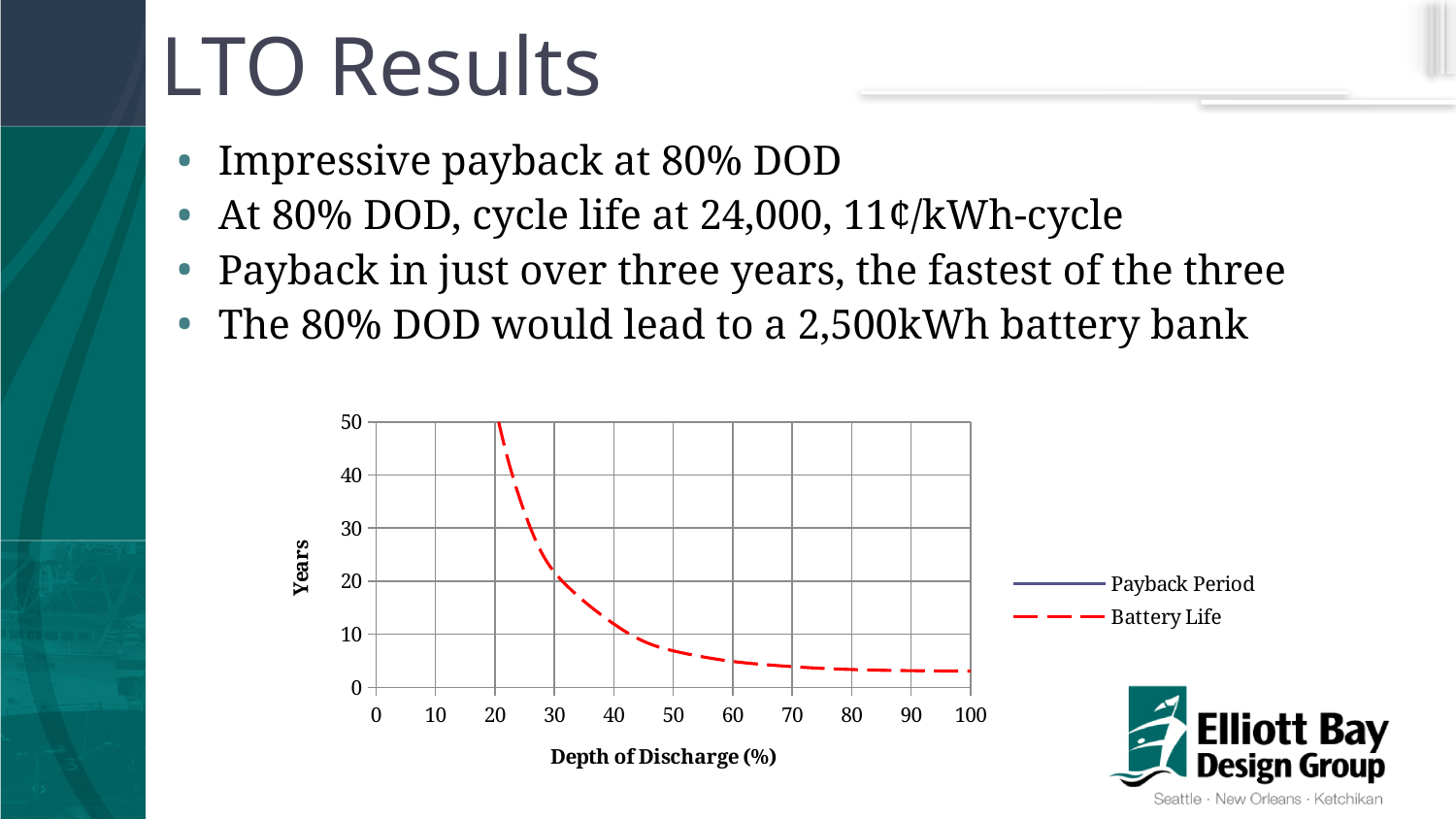
Is the Battery Life value at 80% Depth of Discharge greater or less than 10 years? less What kind of chart is shown on the slide? line chart What are the two series named in the chart legend? Payback Period and Battery Life Does the Battery Life curve rise or fall as Depth of Discharge increases? fall What is the title of the y axis of the chart? Years What is the title of the x axis of the chart? Depth of Discharge (%) What is the highest value shown on the y axis of the chart? 50 Is the Battery Life value at 50% Depth of Discharge greater or less than 10 years? less What is the highest value shown on the x axis of the chart? 100 How many series does the chart legend list? 2 Which series in the chart is drawn as a red dashed line? Battery Life